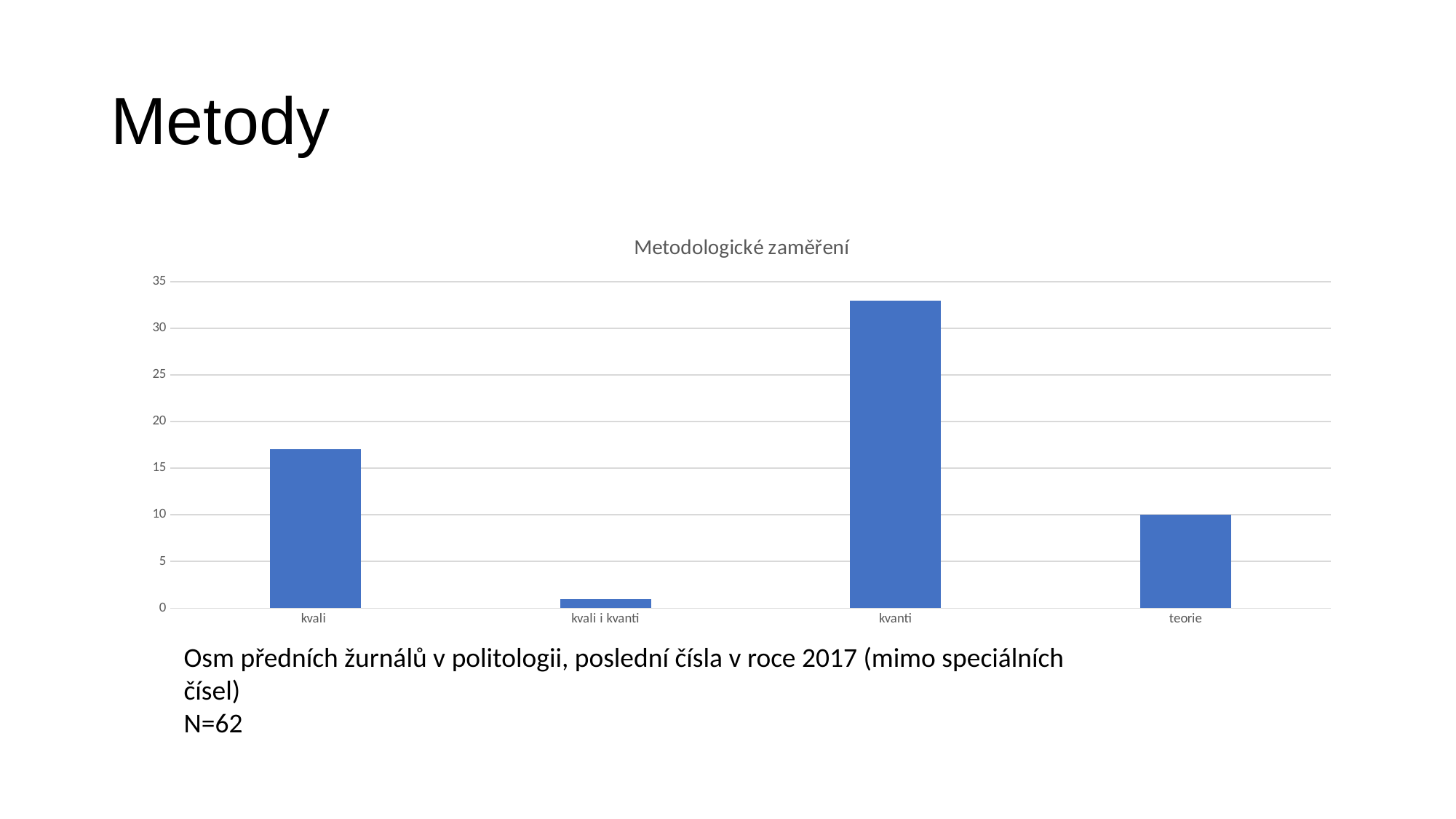
What kind of chart is shown on the slide? bar chart What is the title of the chart? Metodologické zaměření How many categories are shown on the x axis of the chart? 4 Which category has the highest value? kvanti What is the value for teorie? 10 Is the value for kvali greater or less than 15? greater What is the highest value shown on the y axis of the chart? 35 Is the value for kvanti greater or less than 30? greater Which category has the lowest value? kvali i kvanti Is the value for kvali i kvanti greater or less than 5? less Which is larger, the value for kvali or the value for teorie? kvali